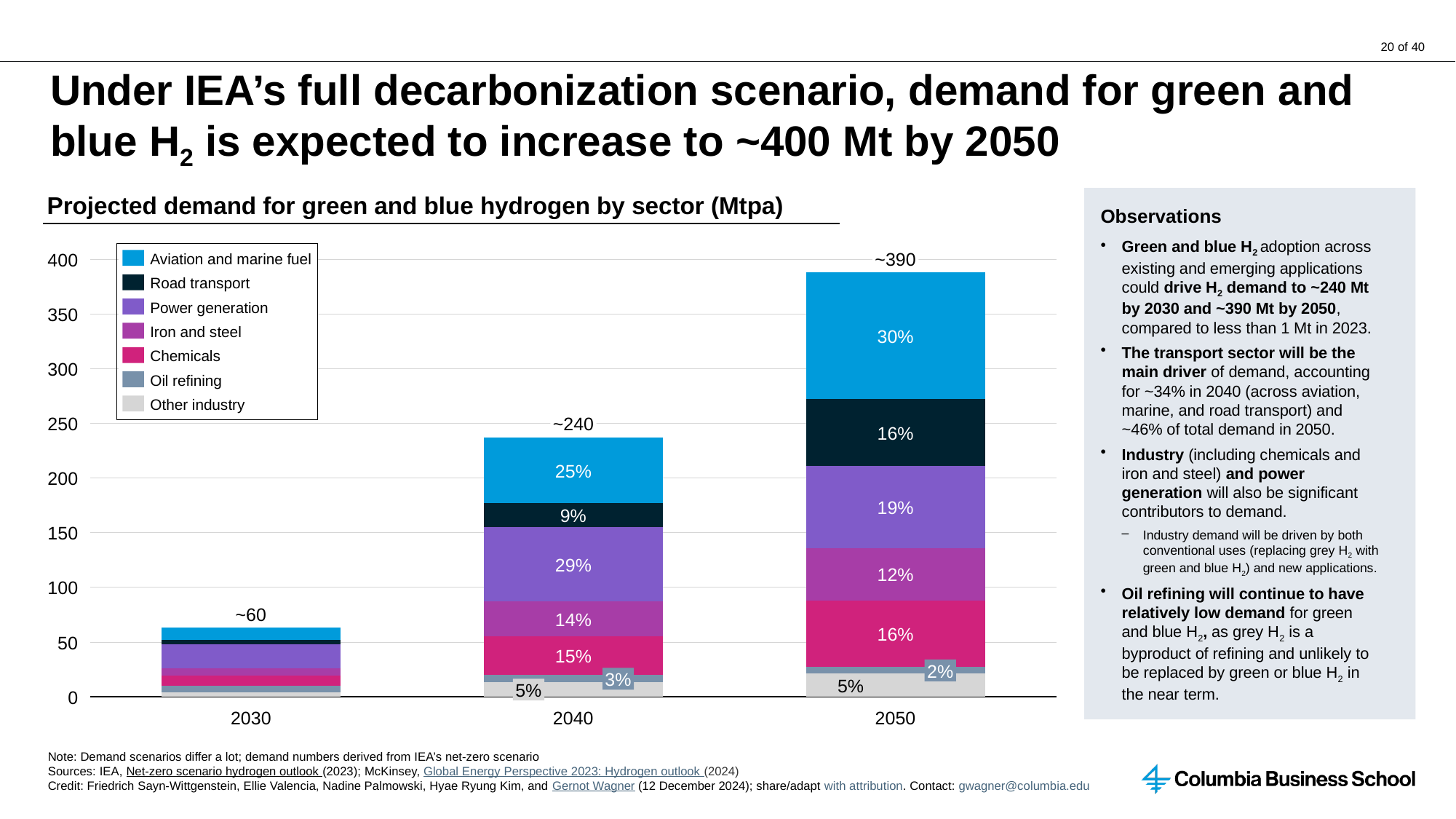
What kind of chart is shown on the slide? Stacked bar chart What share of demand does Aviation and marine fuel account for in 2050? 30% Which year has the highest total projected demand? 2050 Which year has the lowest total projected demand? 2030 Is the Power generation share larger in 2040 or in 2050? 2040 What share of demand does Oil refining account for in 2050? 2% Is the total demand for 2030 greater or less than 100? less How many sectors does the chart legend list? 7 How many years are shown on the x axis of the chart? 3 By how many percentage points does the Aviation and marine fuel share in 2050 exceed its share in 2040? 5 percentage points What share of demand does Power generation account for in 2040? 29% What total is labelled above the 2050 bar? ~390